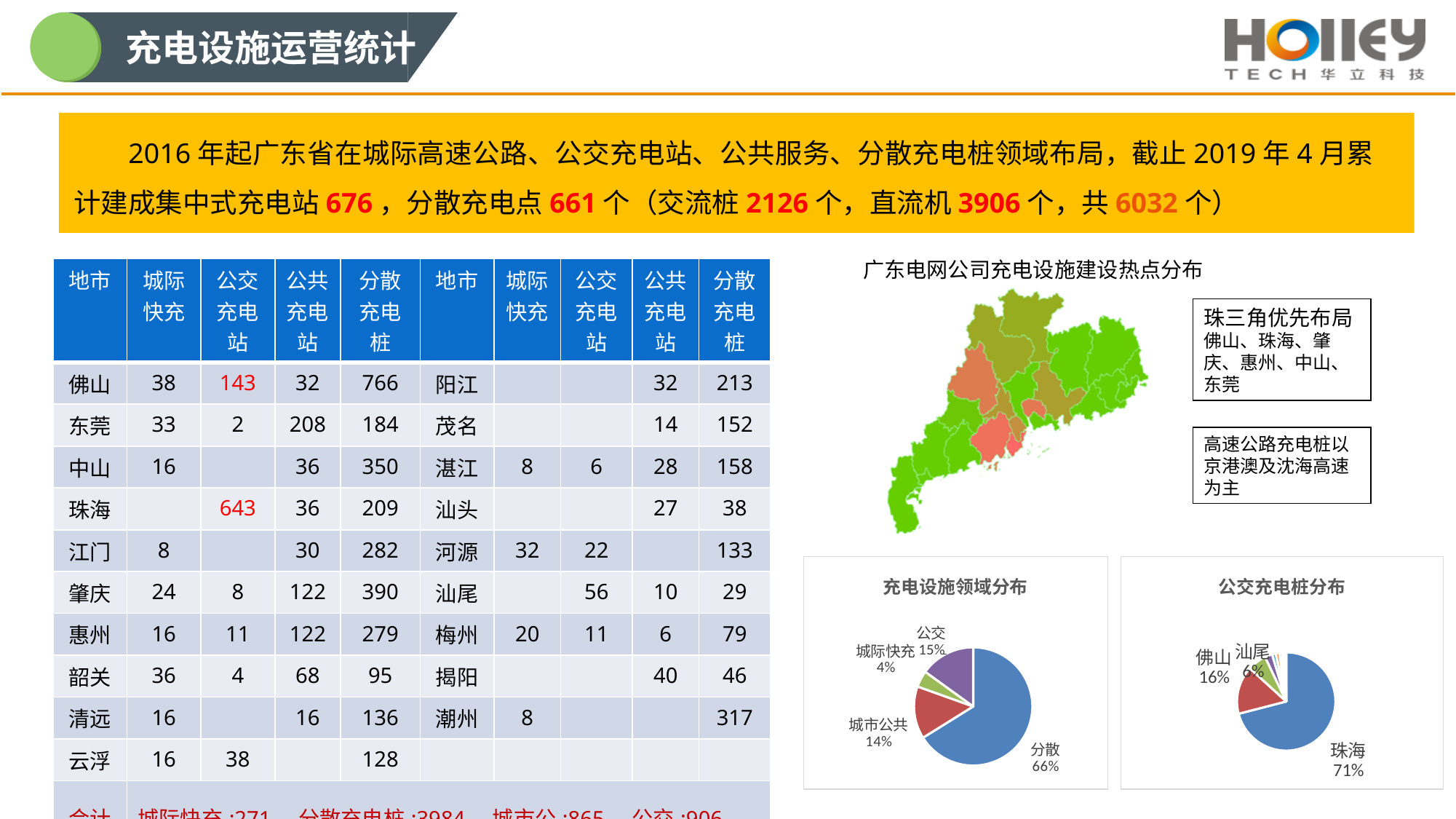
In the '充电设施领域分布' chart, what share does 城际快充 have? 4% In the '充电设施领域分布' chart, what share does 城市公共 have? 14% What kind of chart is '充电设施领域分布'? pie chart In the '充电设施领域分布' chart, what is the difference between the shares of 分散 and 公交? 51% In the '公交充电桩分布' chart, what is the difference between the shares of 佛山 and 汕尾? 10% In the '公交充电桩分布' chart, what share does 珠海 have? 71% In the '充电设施领域分布' chart, which category has the largest share? 分散 In the '公交充电桩分布' chart, which city has the largest share? 珠海 In the '充电设施领域分布' chart, which is larger, 公交 or 城市公共? 公交 In the '充电设施领域分布' chart, which category has the smallest share? 城际快充